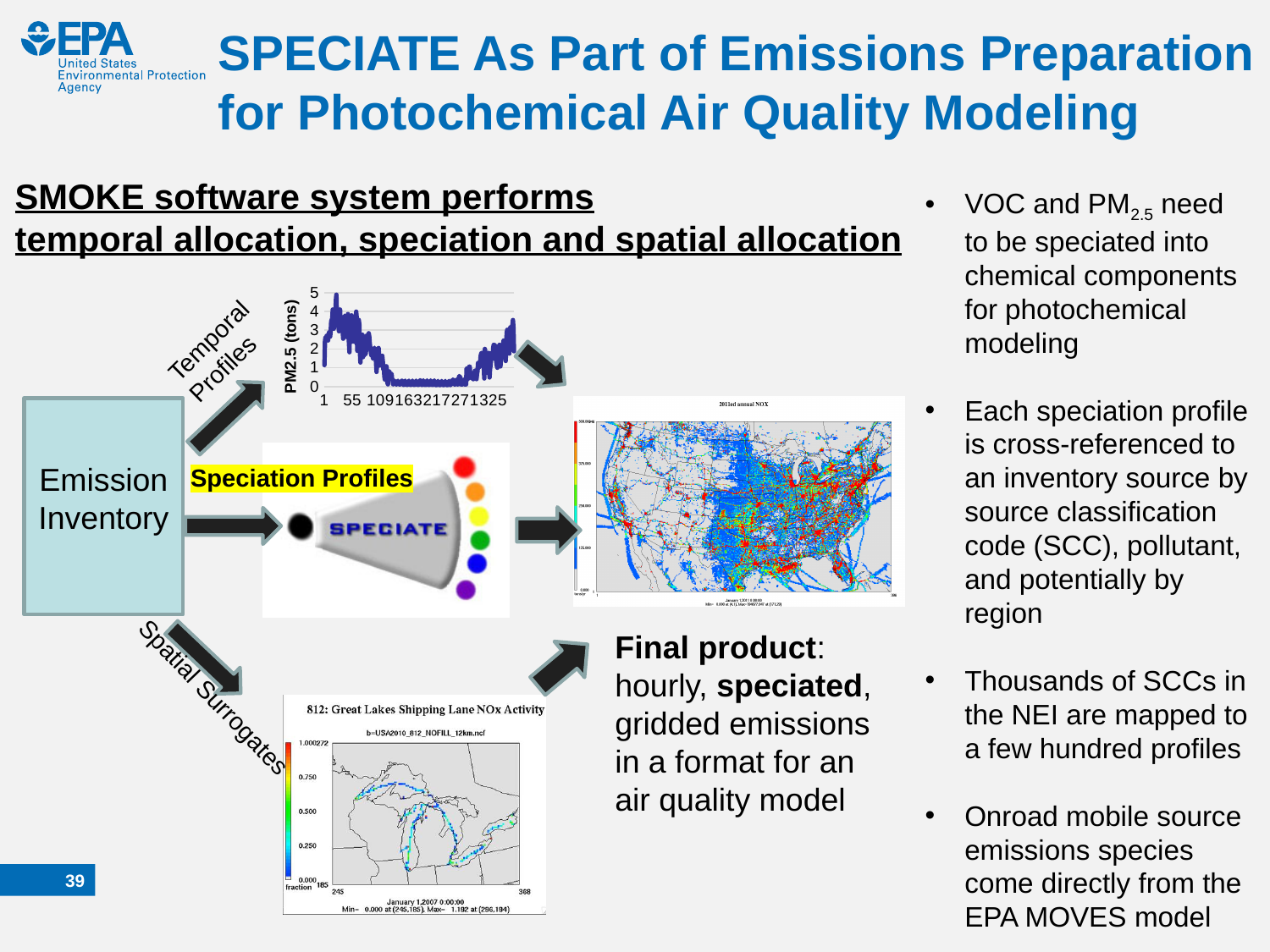
In the PM2.5 line chart, what is the label on the vertical axis? PM2.5 (tons) In the PM2.5 line chart, is the value around x = 325 greater or less than 1? greater In the PM2.5 line chart, is the value around x = 163 greater or less than 1? less What kind of chart is the small PM2.5 chart near the top of the slide? line chart In the PM2.5 line chart, do the values rise or fall between x = 55 and x = 163? fall In the PM2.5 line chart, do the values rise or fall between x = 217 and x = 325? rise In the PM2.5 line chart, what is the highest tick value shown on the vertical axis? 5 How many tick labels are shown on the horizontal axis of the PM2.5 line chart? 7